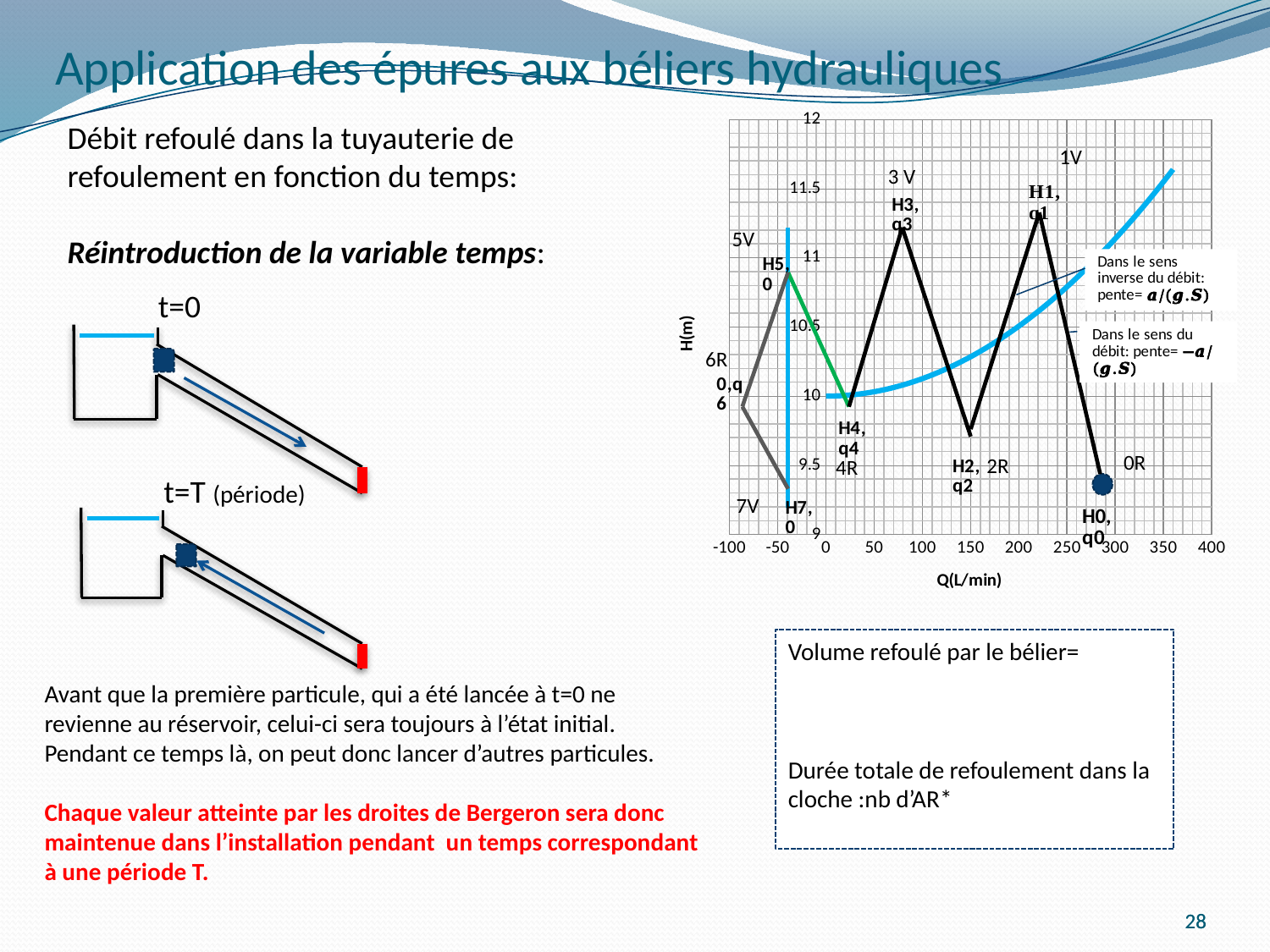
Is the H value at the point labelled H2, q2 greater or less than 10.5? less What is the label of the horizontal axis of the chart? Q(L/min) Is the H value at the point labelled H1, q1 greater or less than 11? greater Which point has the higher H value, H1, q1 or H0, q0? H1, q1 Is the H value at the point labelled H3, q3 greater or less than 11? greater Which point has the larger Q value, H0, q0 or H2, q2? H0, q0 What kind of chart is shown on the right of the slide? line chart What is the label of the vertical axis of the chart? H(m) Which point has the higher H value, H3, q3 or H2, q2? H3, q3